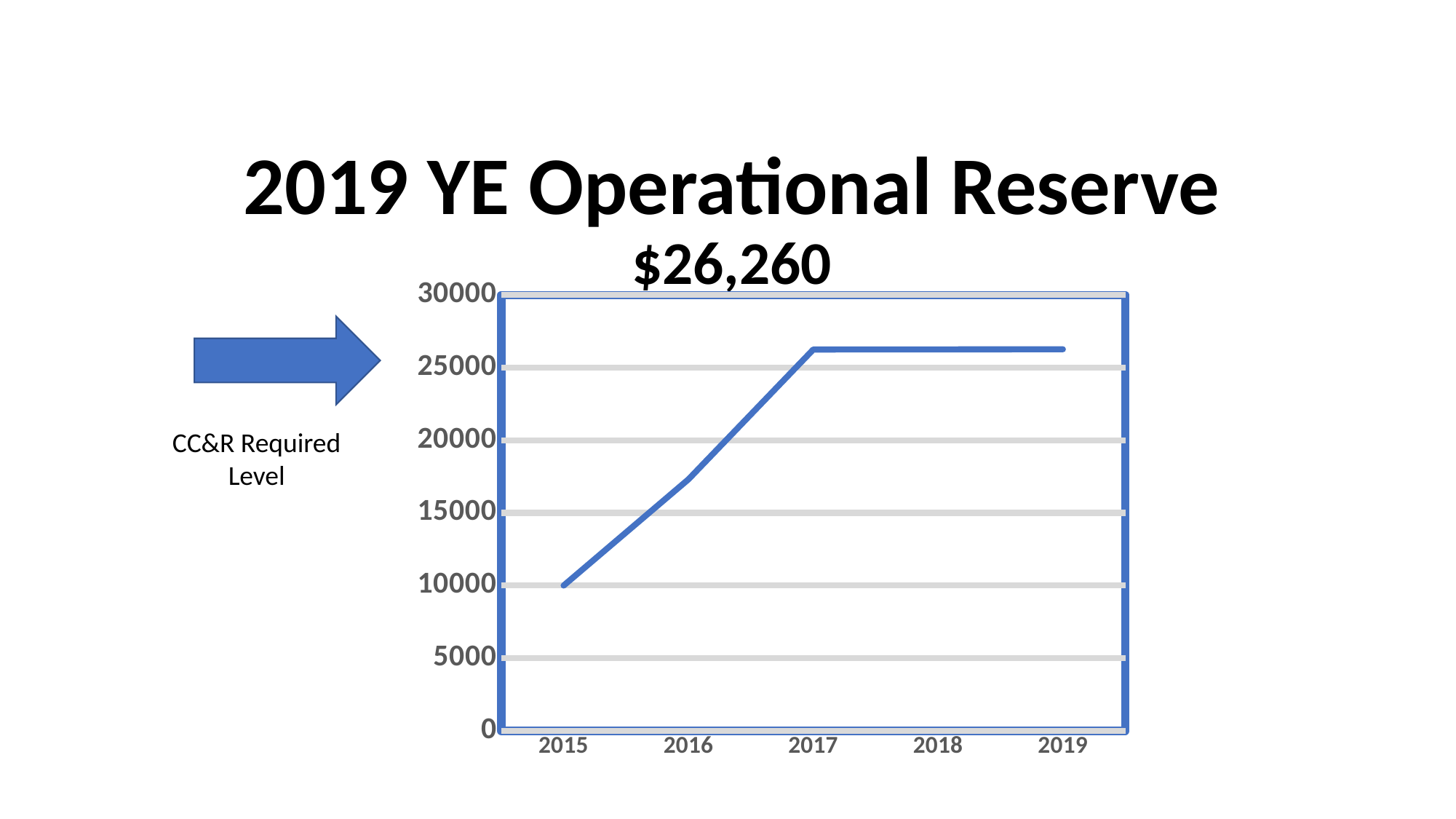
What kind of chart is shown on the slide? line chart Which year has the lowest value on the chart? 2015 Which year has the larger value, 2015 or 2016? 2016 Is the value for 2017 greater or less than 25000? greater Do the values rise or fall from 2015 to 2017? rise How many years are plotted on the x axis of the chart? 5 Is the value for 2016 greater or less than 15000? greater Is the value for 2018 greater or less than 30000? less Which year has the larger value, 2016 or 2017? 2017 What is the title of the slide above the chart? 2019 YE Operational Reserve